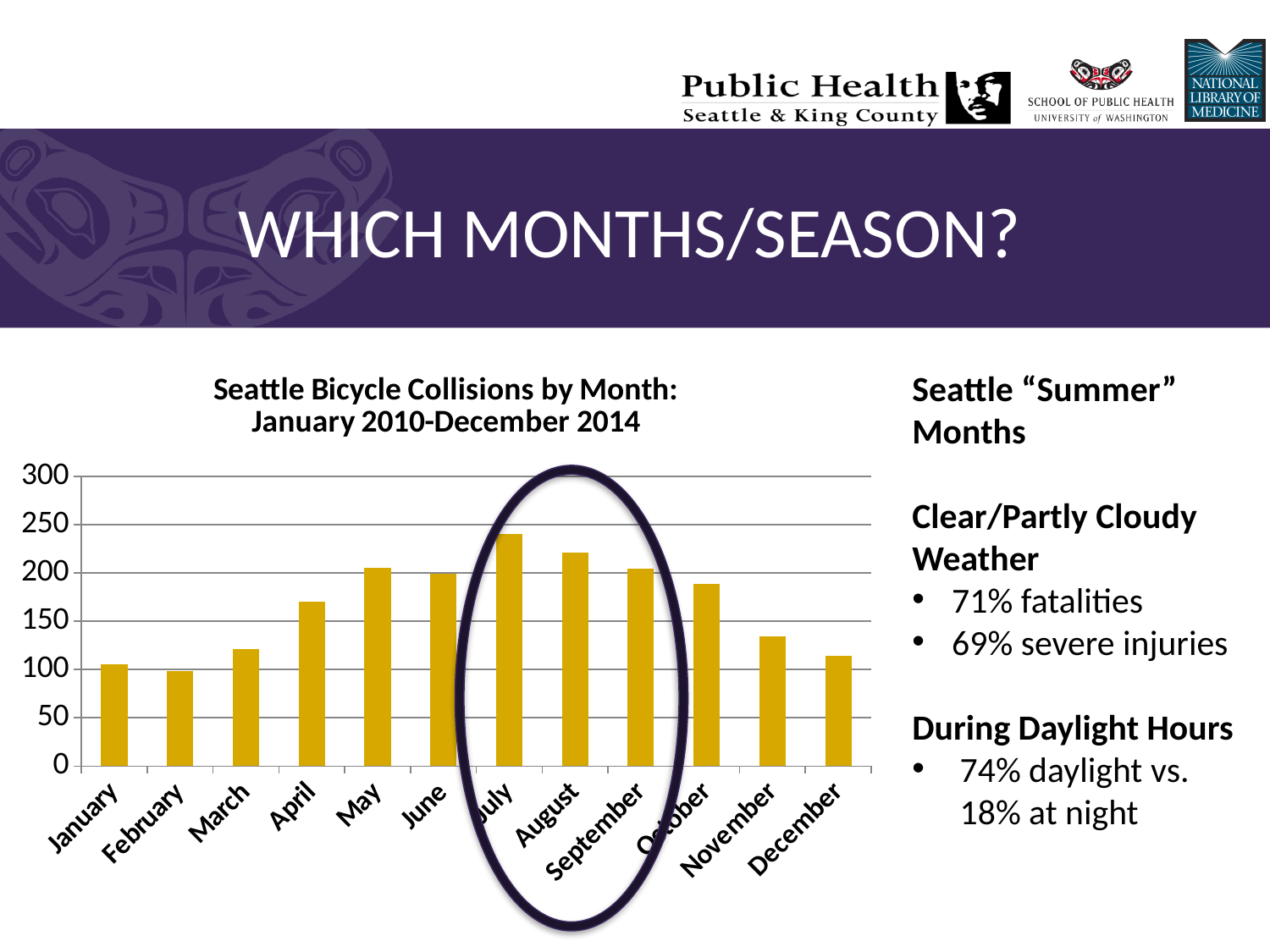
Is the value for April greater or less than 150? greater Is the value for July greater or less than 200? greater What type of chart is shown on the slide? bar chart How many months are shown on the x axis of the chart? 12 Is the value for October greater or less than 200? less Which month has the highest number of bicycle collisions? July Do the values rise or fall from January to July? rise What is the title of the chart? Seattle Bicycle Collisions by Month: January 2010-December 2014 Which has more collisions, April or November? April Which has more collisions, July or December? July